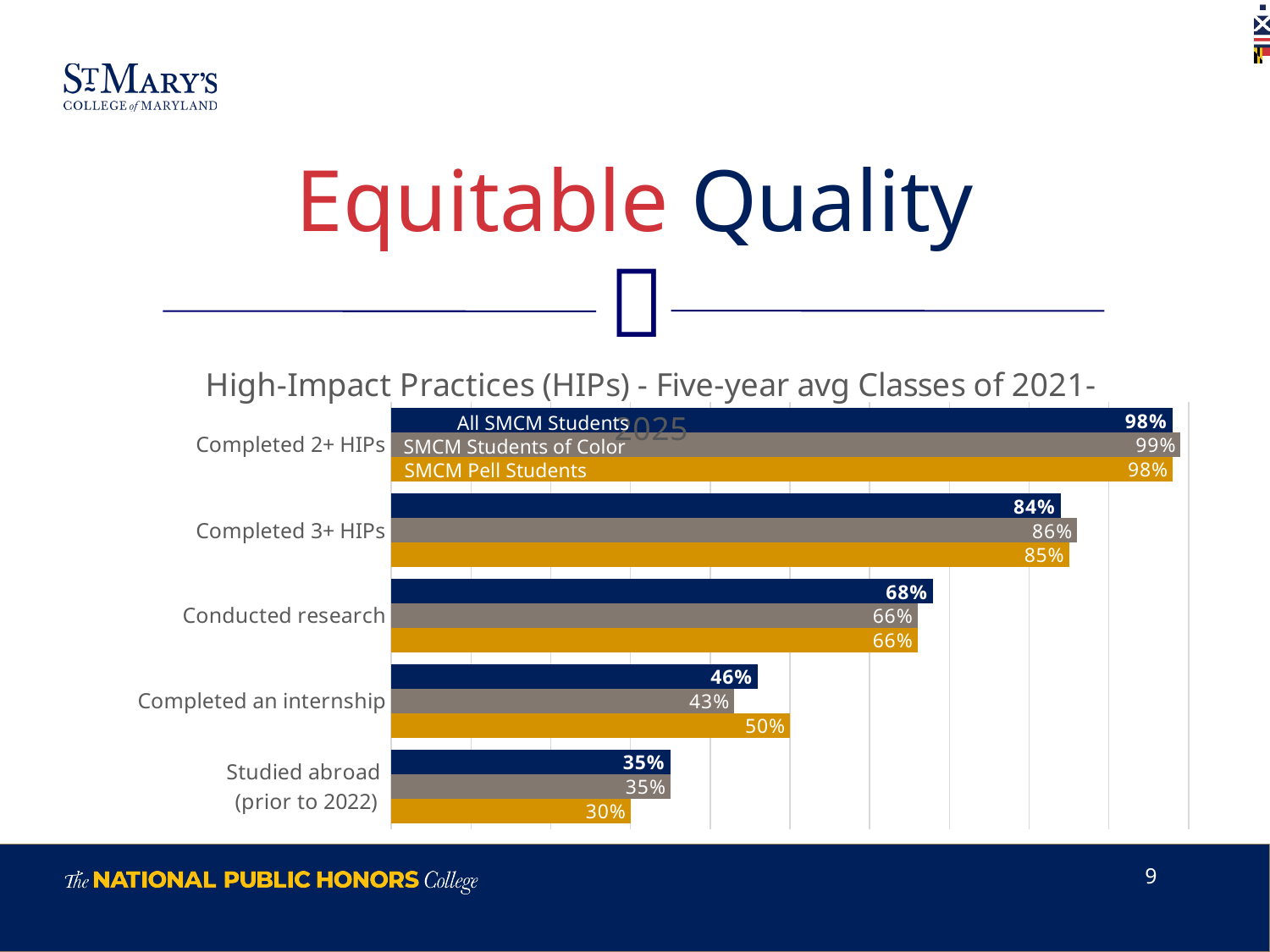
For Conducted research, which is larger: the value for All SMCM Students or the value for SMCM Pell Students? All SMCM Students Which category has the lowest value for All SMCM Students? Studied abroad (prior to 2022) What is the value for SMCM Pell Students for Studied abroad (prior to 2022)? 30% How many series does the chart's legend list? 3 How many categories (high-impact practices) does the chart show? 5 Which category has the highest value for SMCM Pell Students? Completed 2+ HIPs What is the value for SMCM Students of Color for Completed 2+ HIPs? 99% What kind of chart is shown on the slide? bar chart What is the value for SMCM Pell Students for Completed an internship? 50% Which series is shown in gold bars? SMCM Pell Students What is the value for All SMCM Students for Completed 3+ HIPs? 84% What is the difference between the SMCM Pell Students value and the SMCM Students of Color value for Completed an internship? 7%